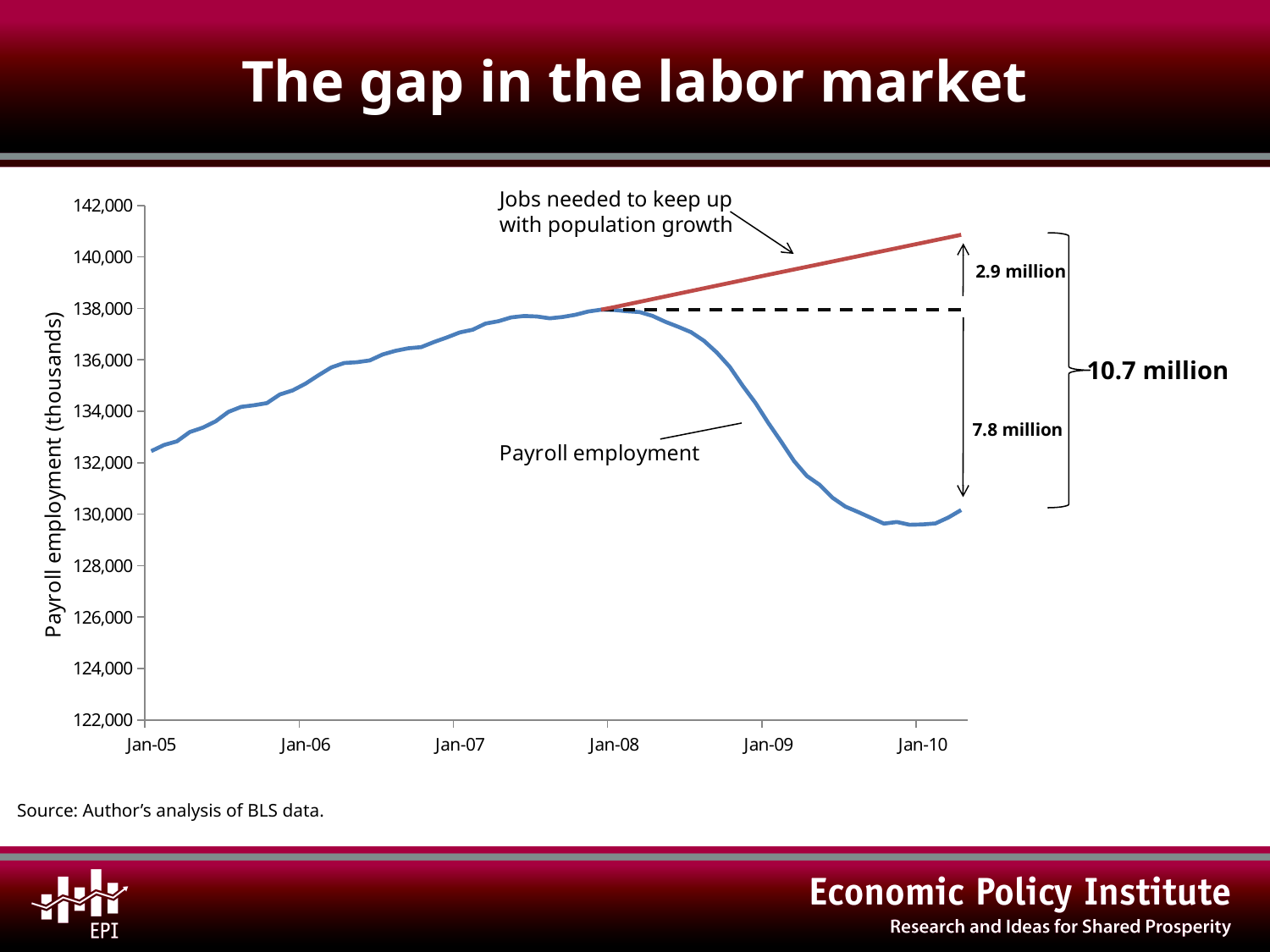
Is the payroll employment value at Jan-05 greater or less than 134,000? less What is the label on the vertical axis of the chart? Payroll employment (thousands) What is the total labor market gap shown by the bracket on the right of the chart? 10.7 million According to the annotation, how many jobs were lost in payroll employment (the gap between the dashed line and the blue line)? 7.8 million What kind of chart is shown on the slide? Line chart Is the final value of the 'Jobs needed to keep up with population growth' line greater or less than 140,000? greater According to the annotation, how many jobs were needed to keep up with population growth (the gap between the red line and the dashed line)? 2.9 million At Jan-10, which line is higher: 'Jobs needed to keep up with population growth' or 'Payroll employment'? Jobs needed to keep up with population growth What is the title of the slide's chart? The gap in the labor market Does payroll employment rise or fall between Jan-08 and Jan-10? Fall Is the payroll employment value at Jan-10 greater or less than 132,000? less Does payroll employment rise or fall between Jan-05 and Jan-08? Rise